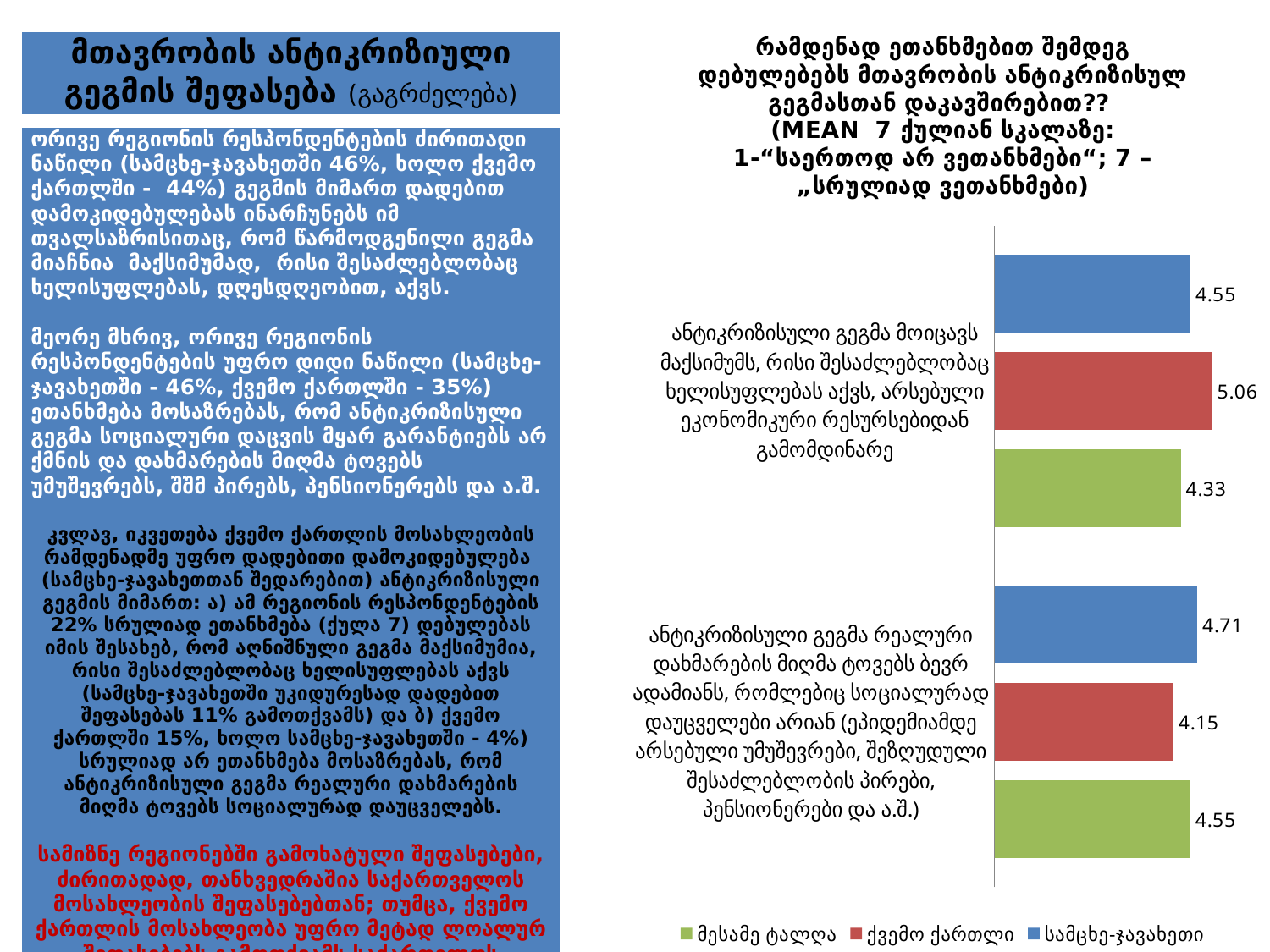
Which colour represents მესამე ტალღა in the chart legend? green For the bottom statement (ანტიკრიზისული გეგმა რეალური დახმარების მიღმა ტოვებს...), which is larger: the value for სამცხე-ჯავახეთი or the value for ქვემო ქართლი? სამცხე-ჯავახეთი What kind of chart is shown on the right side of the slide? bar chart What is the difference between the ქვემო ქართლი value and the მესამე ტალღა value for the top statement (ანტიკრიზისული გეგმა მოიცავს მაქსიმუმს...)? 0.73 What is the value for ქვემო ქართლი for the bottom statement (ანტიკრიზისული გეგმა რეალური დახმარების მიღმა ტოვებს...)? 4.15 Which series has the highest value for the top statement (ანტიკრიზისული გეგმა მოიცავს მაქსიმუმს...)? ქვემო ქართლი How many series does the legend of the chart list? 3 Which series has the lowest value for the bottom statement (ანტიკრიზისული გეგმა რეალური დახმარების მიღმა ტოვებს...)? ქვემო ქართლი What is the value for მესამე ტალღა for the bottom statement (ანტიკრიზისული გეგმა რეალური დახმარების მიღმა ტოვებს...)? 4.55 What is the value for ქვემო ქართლი for the top statement (ანტიკრიზისული გეგმა მოიცავს მაქსიმუმს...)? 5.06 How many categories (statements) are plotted on the chart? 2 What is the value for სამცხე-ჯავახეთი for the top statement (ანტიკრიზისული გეგმა მოიცავს მაქსიმუმს...)? 4.55